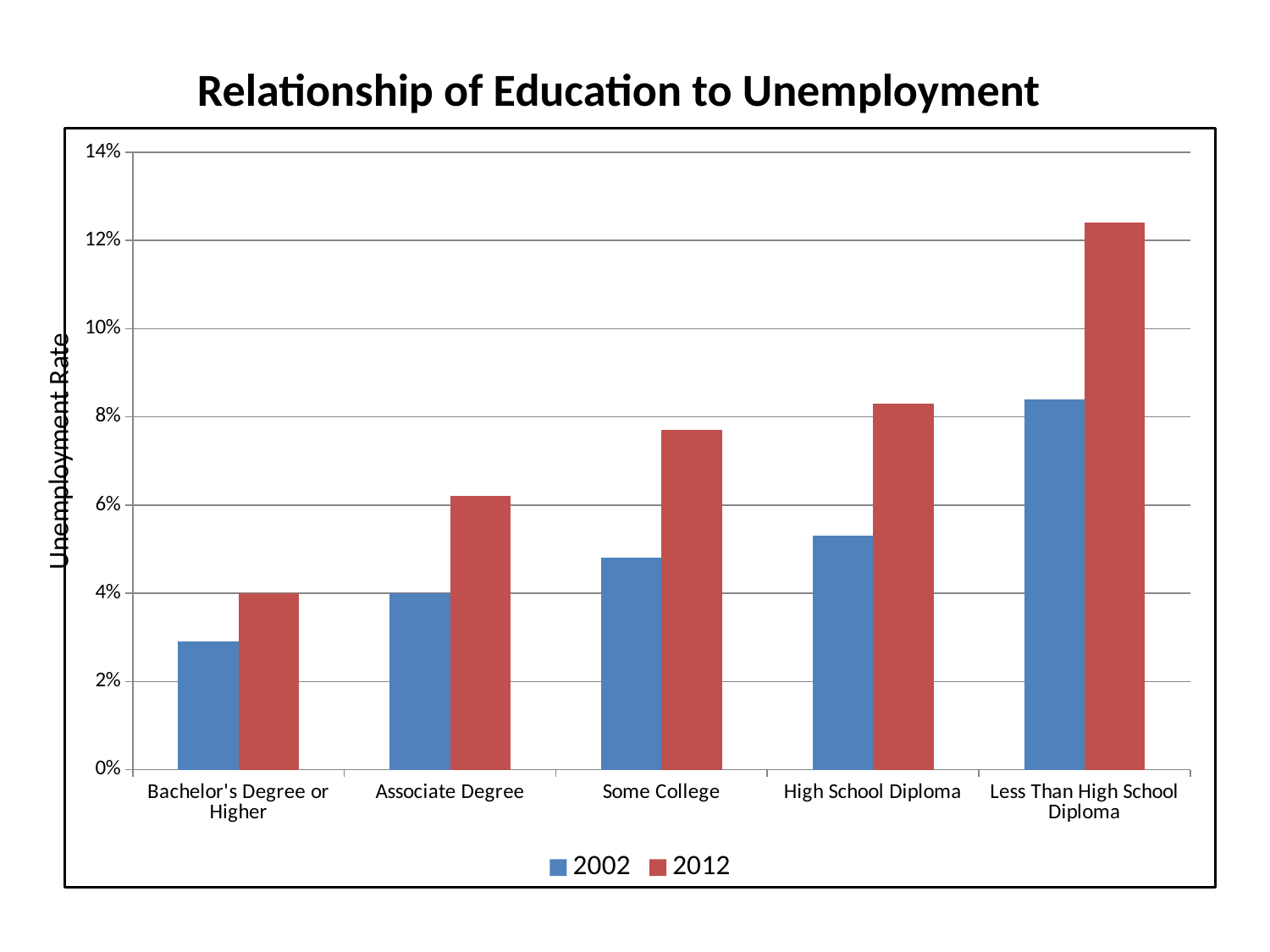
How many series does the legend list? 2 Is the 2002 unemployment rate for Some College greater or less than 6%? less Moving from Bachelor's Degree or Higher to Less Than High School Diploma along the x axis, do the 2012 unemployment rates rise or fall? rise Which education category has the lowest 2002 unemployment rate? Bachelor's Degree or Higher Which education category has the highest 2012 unemployment rate? Less Than High School Diploma What kind of chart is shown on the slide? bar chart Is the 2012 unemployment rate for Less Than High School Diploma greater or less than 12%? greater Is the 2012 unemployment rate for High School Diploma greater or less than 8%? greater For Associate Degree, which year has the higher unemployment rate, 2002 or 2012? 2012 How many education categories are shown on the x axis? 5 What is the title of the chart? Relationship of Education to Unemployment